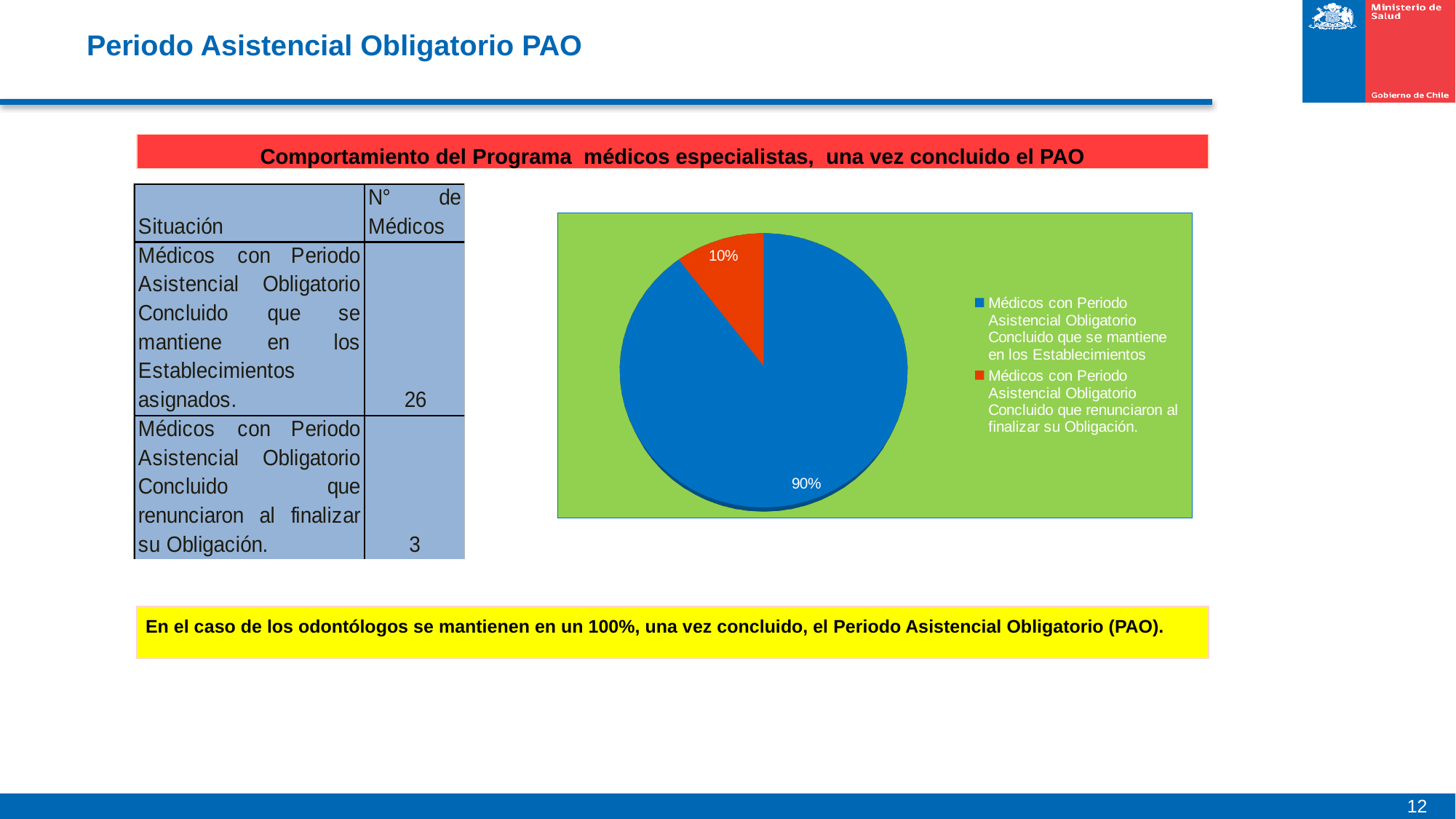
How many entries does the legend of the pie chart list? 2 What share of the pie is labelled for doctors who resigned at the end of their obligation? 10% What kind of chart is shown on the slide? pie chart What colour is the slice for doctors who resigned at the end of their obligation? red Which category has the smallest slice of the pie? Médicos con Periodo Asistencial Obligatorio Concluido que renunciaron al finalizar su Obligación Which slice is larger: the one for doctors who remain in the establishments or the one for doctors who resigned? doctors who remain in the establishments How many slices does the pie chart have? 2 What colour is the slice for doctors who remain in the establishments? blue What is the difference in percentage points between the two slices of the pie chart? 80 What share of the pie is labelled for doctors who remain in their assigned establishments after completing the PAO? 90% Which category has the largest slice of the pie? Médicos con Periodo Asistencial Obligatorio Concluido que se mantiene en los Establecimientos